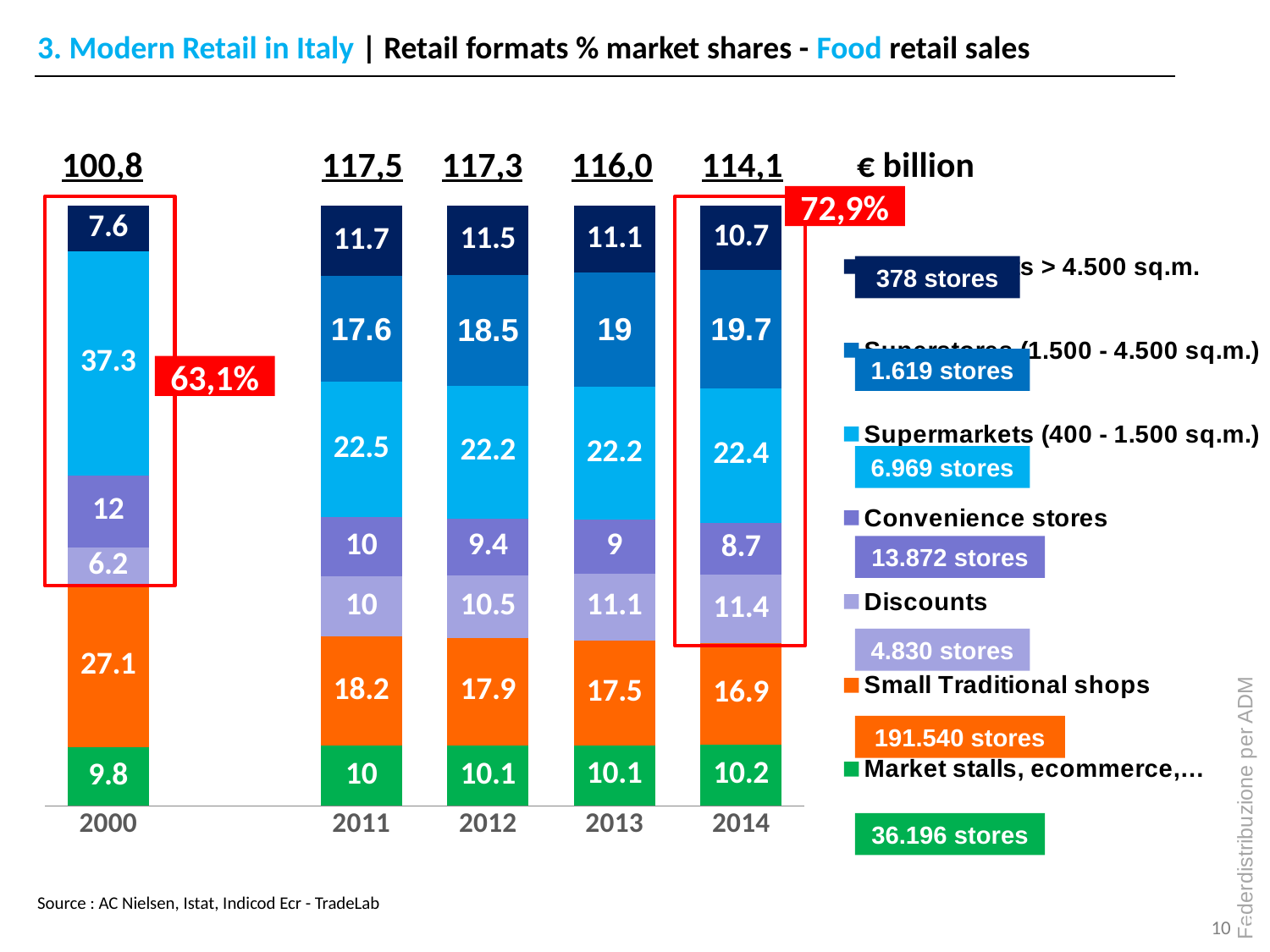
Which series has the largest segment in the 2000 bar? Supermarkets (400 - 1.500 sq.m.) What is the value for Convenience stores in 2012? 9.4 What is the value for Small Traditional shops in 2000? 27.1 How many series does the legend list? 7 By how much did the Small Traditional shops value fall from 2000 to 2014? 10.2 What is the value for Supermarkets (400 - 1.500 sq.m.) in 2014? 22.4 Which is larger in 2014: Discounts or Convenience stores? Discounts What kind of chart is shown on the slide? Stacked bar chart What is the value for Discounts in 2013? 11.1 How many years are shown on the x axis? 5 Does the Small Traditional shops value rise or fall from 2011 to 2014? Fall Which series has the smallest segment in the 2000 bar? Discounts